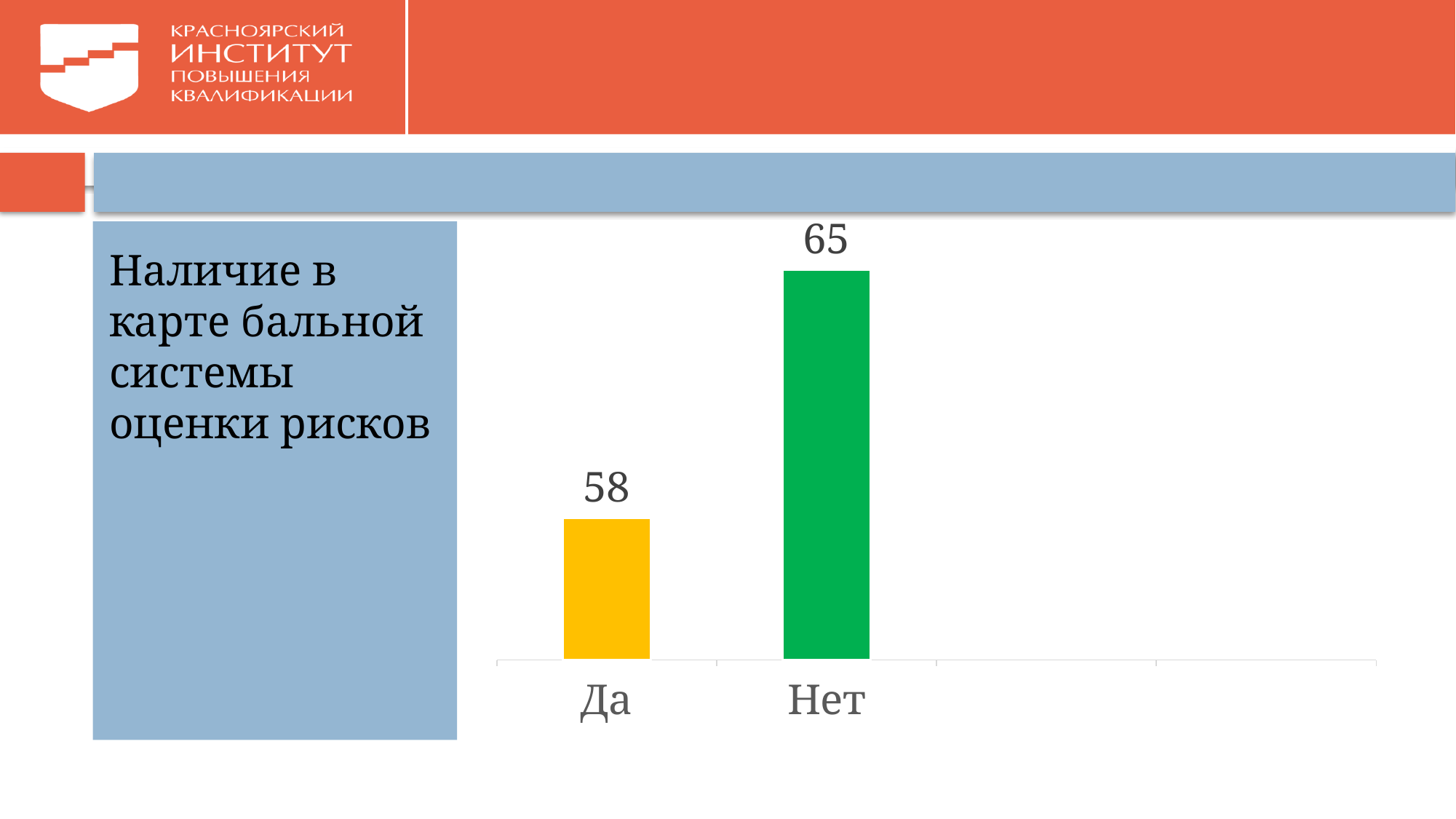
How many categories are shown in the chart? 2 Which category has the lowest value? Да What colour is the bar for "Да"? yellow What colour is the bar for "Нет"? green What is the value for "Нет"? 65 Which is larger, the value for "Да" or the value for "Нет"? Нет What is the difference between the values for "Нет" and "Да"? 7 What kind of chart is shown on the slide? bar chart Which category has the highest value? Нет What is the value for "Да"? 58 What is the total of the two values shown in the chart? 123